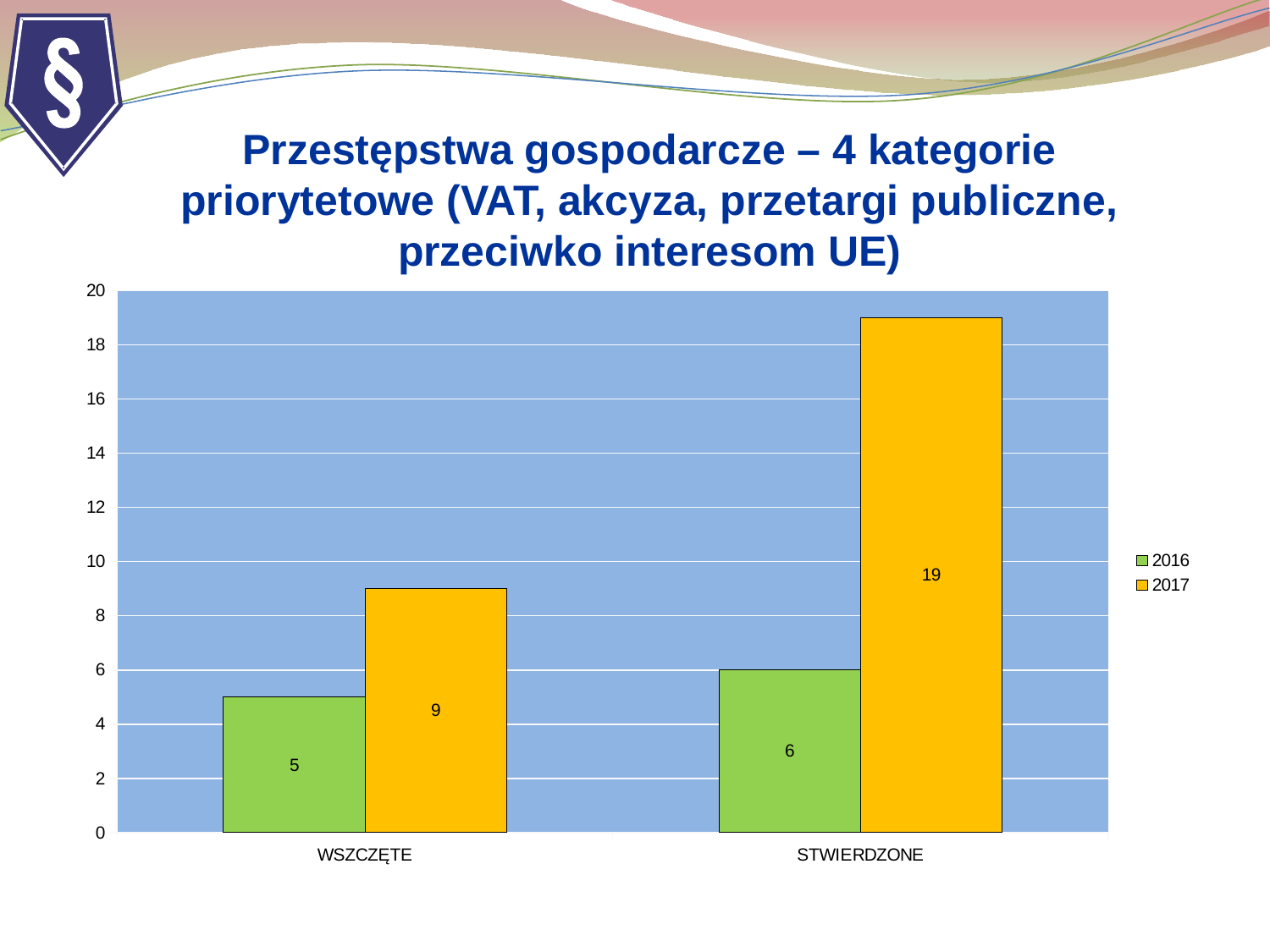
What kind of chart is shown on the slide? bar chart How many categories are shown on the x axis? 2 What is the difference between the 2017 and 2016 values for STWIERDZONE? 13 What is the value for WSZCZĘTE in 2017? 9 Which category has the lowest value in the 2016 series? WSZCZĘTE What is the value for WSZCZĘTE in 2016? 5 How many series does the legend list? 2 Which is larger: the 2016 value for STWIERDZONE or the 2017 value for WSZCZĘTE? 2017 value for WSZCZĘTE What is the difference between the 2017 and 2016 values for WSZCZĘTE? 4 What is the value for STWIERDZONE in 2016? 6 What is the value for STWIERDZONE in 2017? 19 Which category has the highest value in the 2017 series? STWIERDZONE